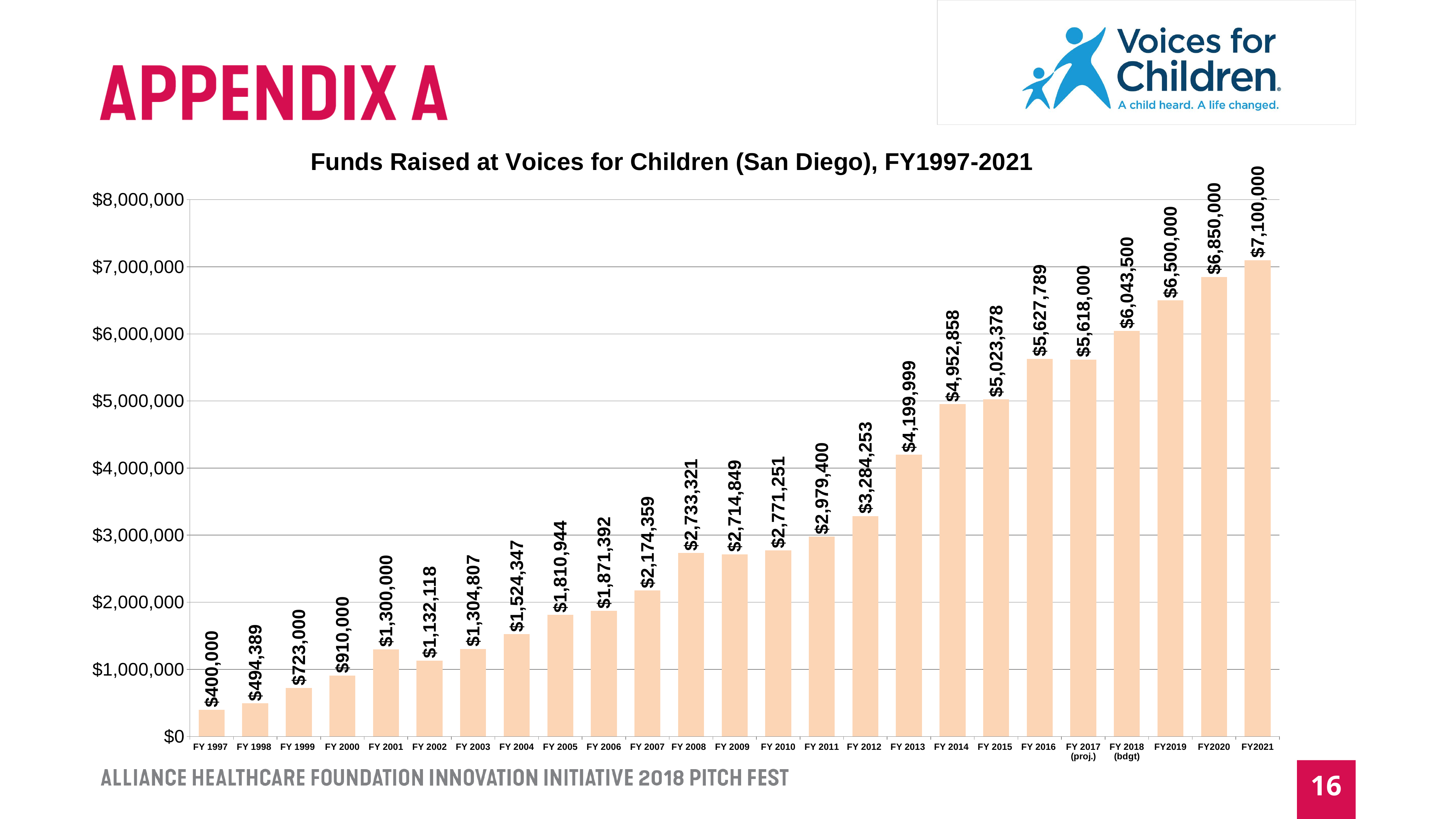
What is the value shown for FY 2013? $4,199,999 What is the title of the chart? Funds Raised at Voices for Children (San Diego), FY1997-2021 How much was raised in FY 1997? $400,000 What is the difference between the funds raised in FY2021 and FY 1997? $6,700,000 What is the difference between the values for FY2020 and FY2019? $350,000 What is the overall trend of funds raised from FY 1997 to FY2021? Rising Which is larger, the value for FY 2001 or FY 2002? FY 2001 Which fiscal year has the lowest funds raised? FY 1997 How many fiscal years are plotted in the chart? 25 Which fiscal year has the highest funds raised? FY2021 What type of chart is shown on the slide? Bar chart What is the value shown for FY 2017 (proj.)? $5,618,000